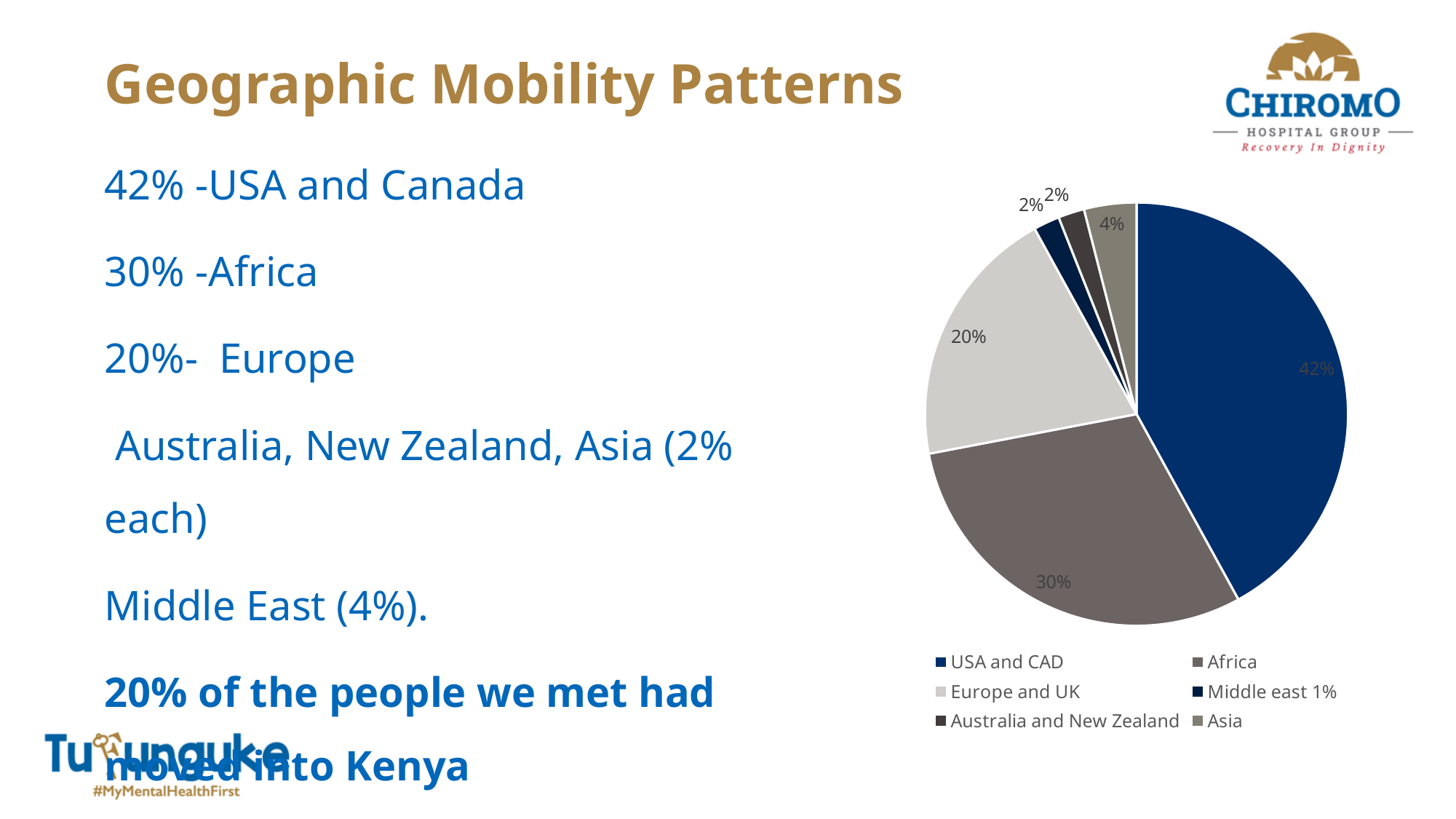
Which is larger in the pie chart, USA and CAD or Europe and UK? USA and CAD What share of the pie chart is Africa? 30% What is the difference in percentage points between USA and CAD and Africa? 12 Which is larger in the pie chart, Africa or Europe and UK? Africa What is the difference in percentage points between Africa and Europe and UK? 10 What is the combined share of USA and CAD and Africa in the pie chart? 72% What is the title of the slide containing the pie chart? Geographic Mobility Patterns How many categories does the pie chart legend list? 6 What type of chart is shown on the slide? pie chart What share of the pie chart is Europe and UK? 20% What share of the pie chart is USA and CAD? 42% Which category has the largest slice in the pie chart? USA and CAD